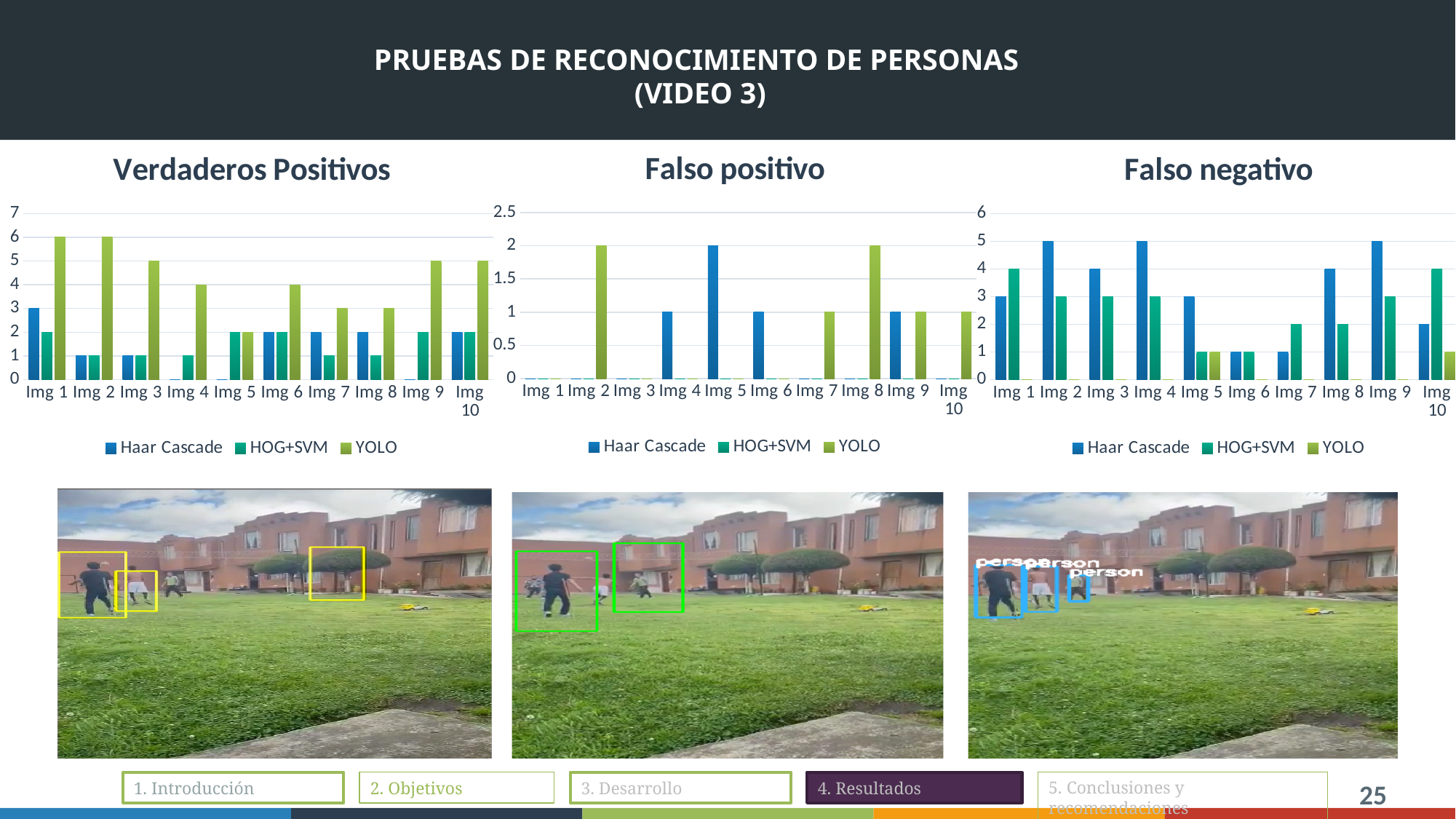
What kind of chart is the Falso positivo chart? Bar chart In the Falso negativo chart, what is the HOG+SVM value for Img 1? 4 In the Falso negativo chart, is the Haar Cascade value for Img 2 greater or less than 4? greater In the Verdaderos Positivos chart, what is the difference between the YOLO and HOG+SVM values for Img 2? 5 In the Verdaderos Positivos chart, what is the Haar Cascade value for Img 1? 3 How many image categories are shown on the x axis of the Verdaderos Positivos chart? 10 In the Falso negativo chart, which is larger for Img 10, Haar Cascade or HOG+SVM? HOG+SVM How many series does the legend of the Falso negativo chart list? 3 In the Verdaderos Positivos chart, which series has the highest value for Img 3? YOLO In the Verdaderos Positivos chart, what is the YOLO value for Img 1? 6 In the Falso positivo chart, what is the Haar Cascade value for Img 4? 1 In the Falso positivo chart, what is the YOLO value for Img 8? 2